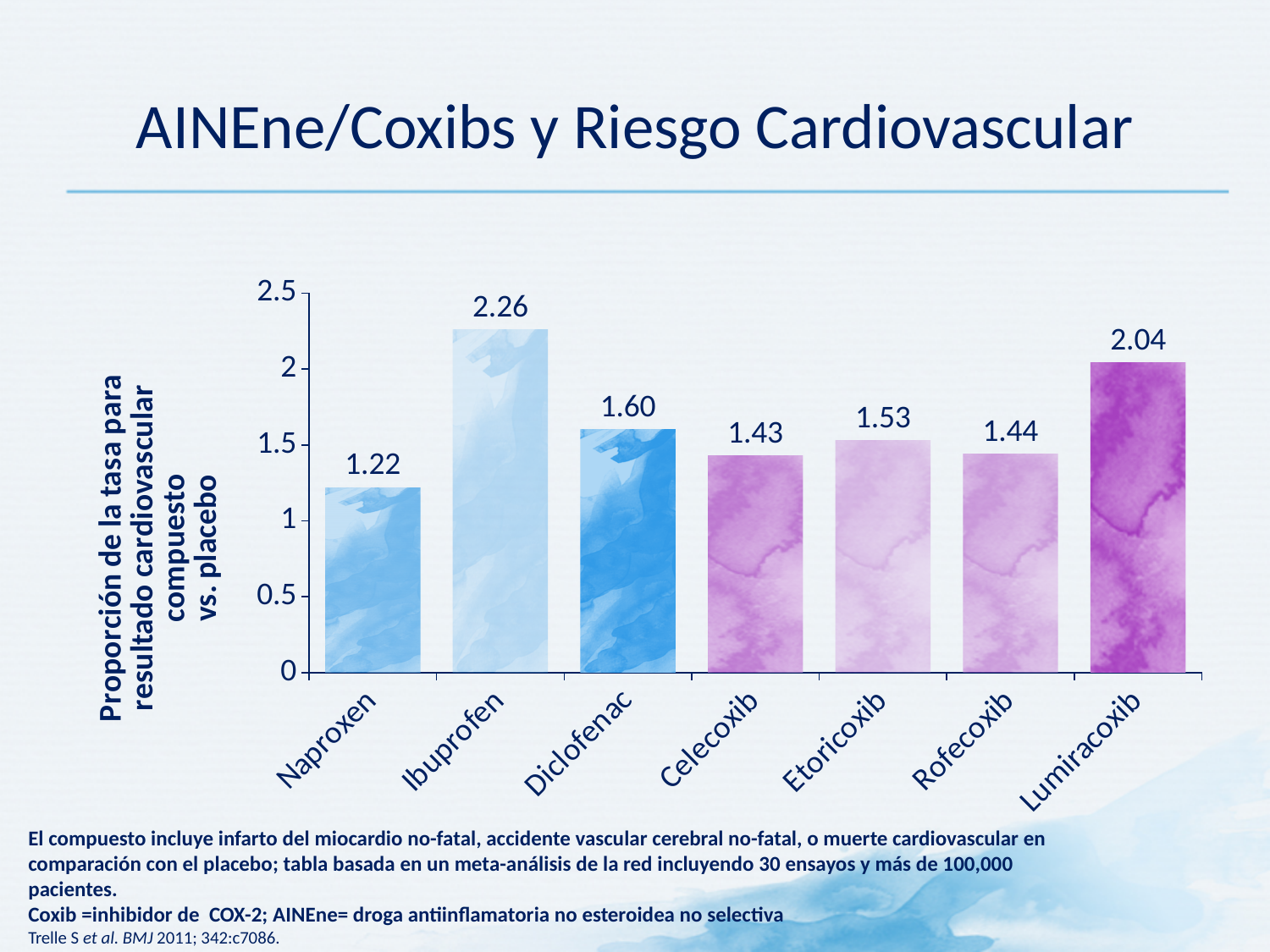
Is the value for Diclofenac greater or less than 1.5? greater What kind of chart is shown on the slide? bar chart What is the difference between the values for Ibuprofen and Naproxen? 1.04 What is the value for Ibuprofen? 2.26 What is the title of the slide? AINEne/Coxibs y Riesgo Cardiovascular What is the difference between the values for Lumiracoxib and Diclofenac? 0.44 Which category has the lowest value? Naproxen How many categories are shown on the x axis? 7 Which has a larger value, Etoricoxib or Rofecoxib? Etoricoxib Which category has the highest value? Ibuprofen What is the value for Lumiracoxib? 2.04 What is the value for Celecoxib? 1.43